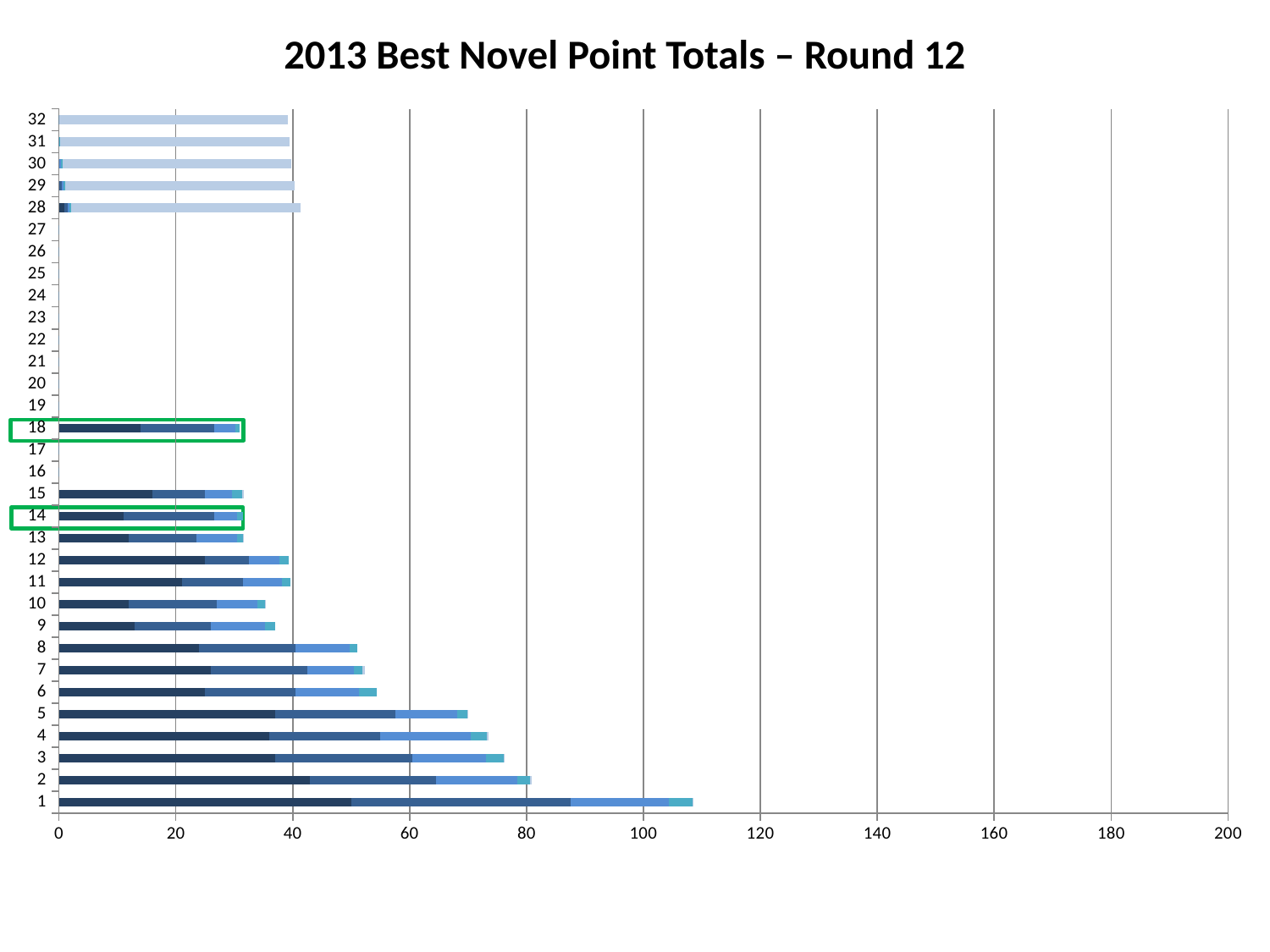
Is the total value for category 1 greater or less than 100? greater How many categories are listed on the vertical axis of the chart? 32 Which two categories are highlighted with green boxes on the chart? 18 and 14 Is the total value for category 6 greater or less than 60? less What is the title of the chart? 2013 Best Novel Point Totals – Round 12 Is the total value for category 18 greater or less than 40? less Which has the larger total, category 5 or category 6? category 5 Which has the larger total, category 1 or category 2? category 1 Going from category 1 up to category 15, do the bars generally get longer or shorter? shorter Which category has the longest bar in the chart? 1 What kind of chart is shown on the slide? bar chart